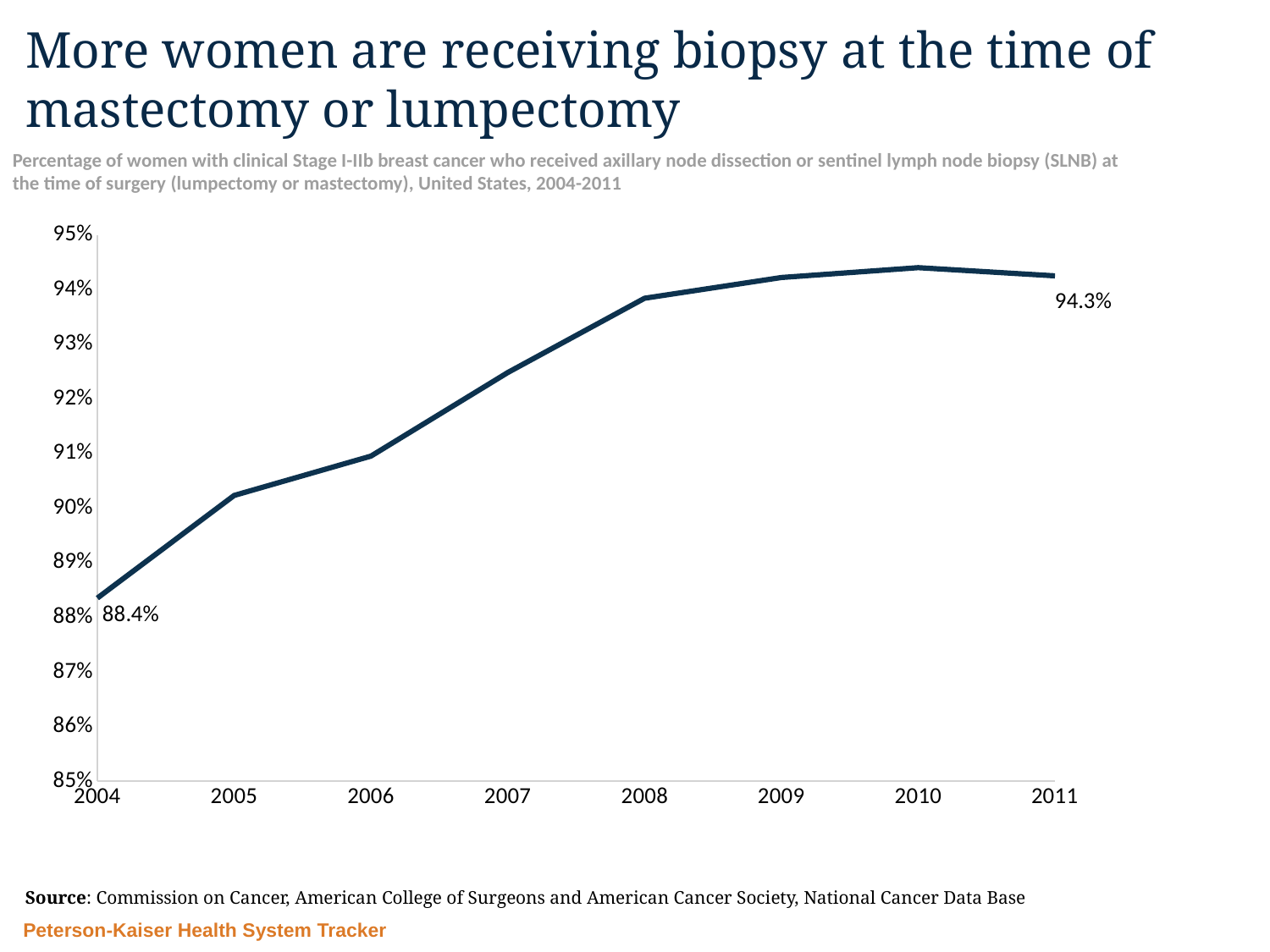
Which year has the lowest value? 2004 Is the value for 2008 greater or less than 93%? greater What is the value for 2011? 94.3% What kind of chart is shown? Line chart What is the value for 2004? 88.4% Do the values generally rise or fall from 2004 to 2011? Rise Is the value for 2006 greater or less than 90%? greater What is the difference between the 2011 value and the 2004 value? 5.9 percentage points Is the value for 2005 greater or less than 91%? less How many years are plotted on the x axis? 8 Which is larger, the value for 2004 or the value for 2011? 2011